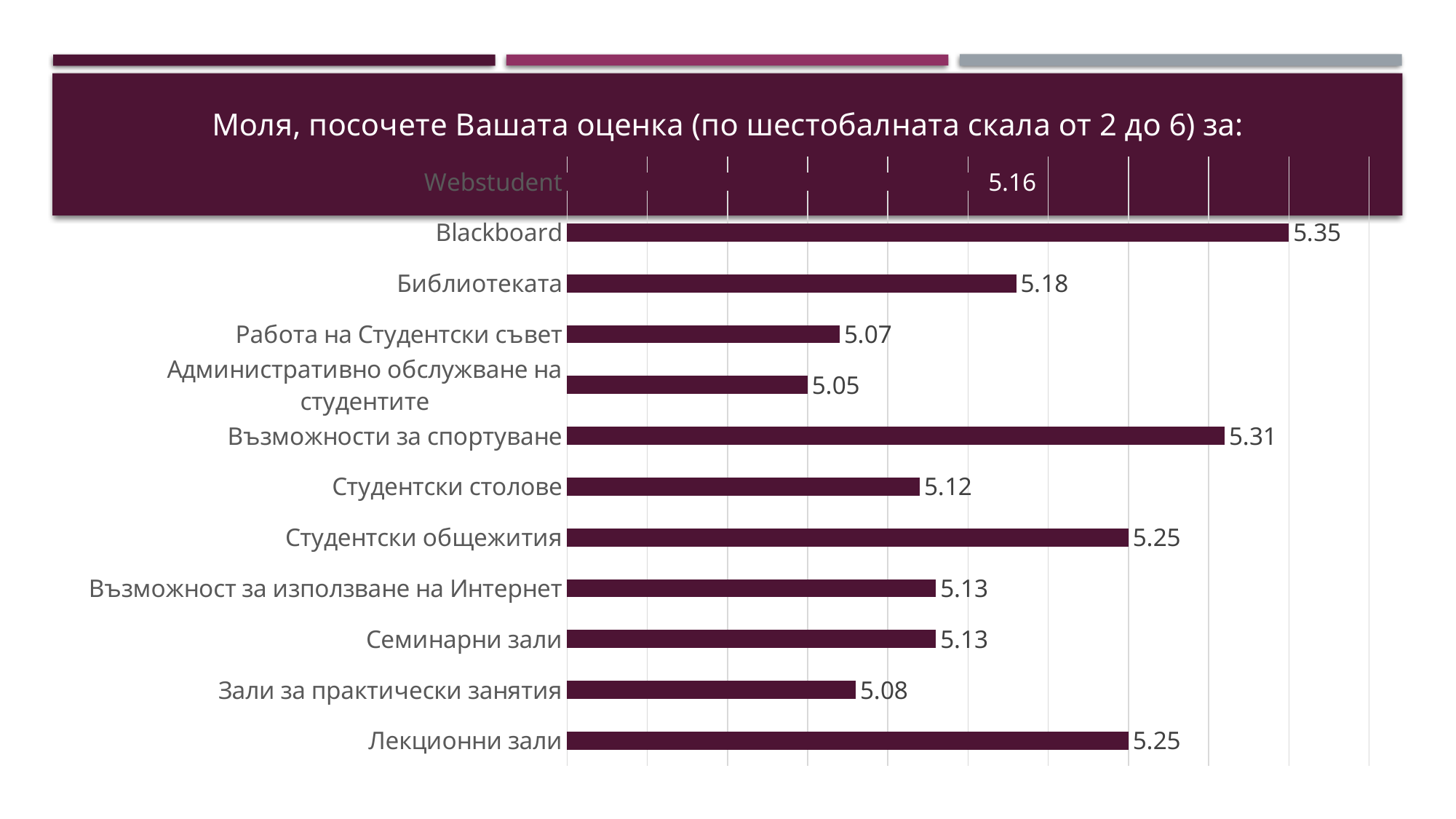
Which has a larger value, Възможности за спортуване or Зали за практически занятия? Възможности за спортуване What kind of chart is shown on the slide? Bar chart What value is shown for Библиотеката? 5.18 What is the difference between the values for Възможности за спортуване and Студентски столове? 0.19 What value is shown for Webstudent? 5.16 Which category has the lowest value? Административно обслужване на студентите What value is shown for Студентски общежития? 5.25 Which category has the highest value? Blackboard What value is shown for Blackboard? 5.35 What is the title of the chart? Моля, посочете Вашата оценка (по шестобалната скала от 2 до 6) за: What is the difference between the values for Blackboard and Административно обслужване на студентите? 0.30 How many categories are shown in the chart? 12